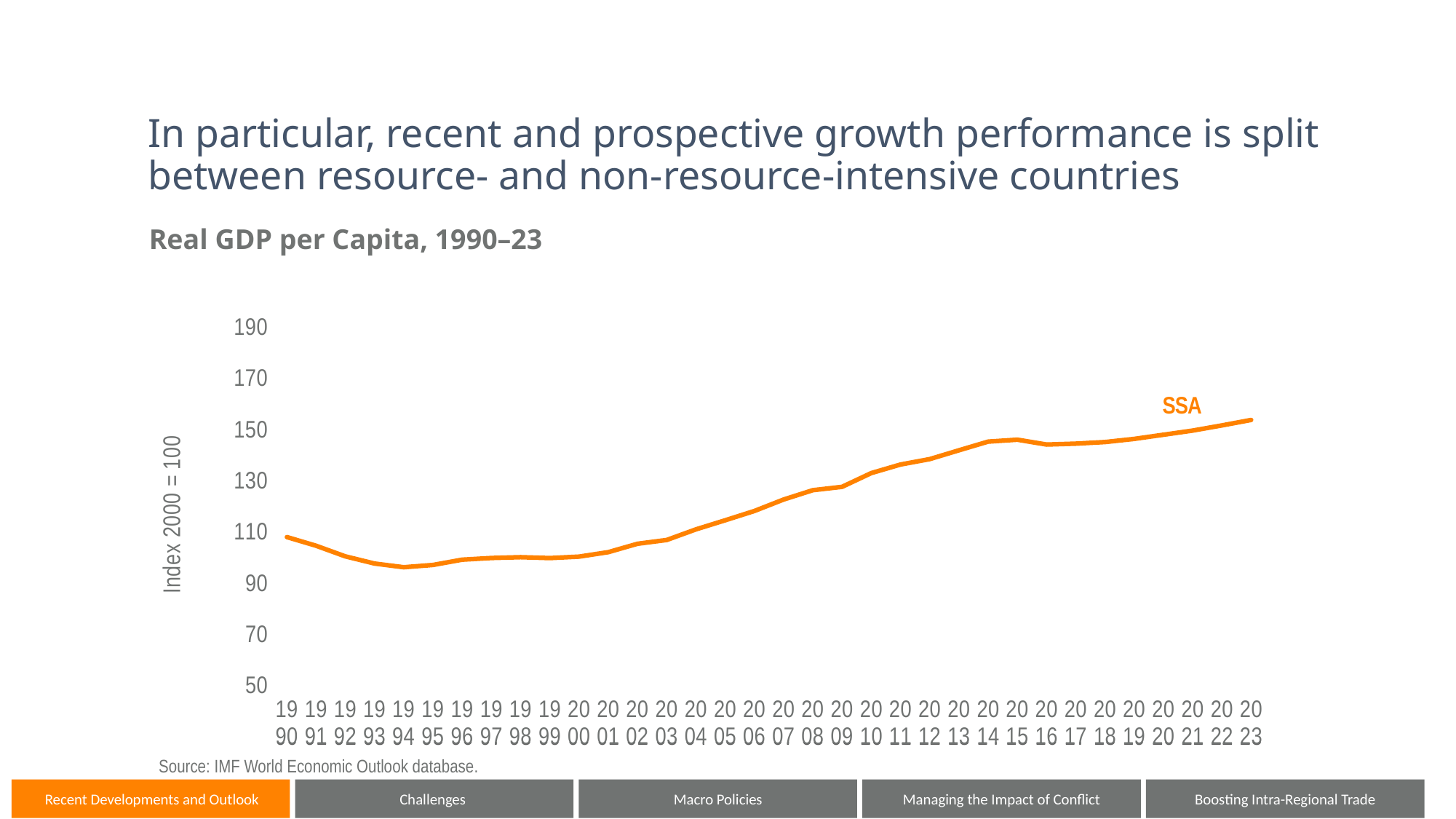
Is the SSA value for 2008 greater or less than 130? less How many years are shown on the x axis of the chart? 34 What kind of chart is shown on the slide? line chart Is the SSA value for 2000 greater or less than 110? less In which year does the SSA line reach its highest value? 2023 What is the name of the series plotted on the chart? SSA How many series does the chart plot? 1 Is the SSA value for 2023 greater or less than 150? greater Which year has the larger SSA value, 1994 or 2005? 2005 What is the title of the chart? Real GDP per Capita, 1990–23 Overall, does the SSA line rise or fall from 1990 to 2023? rise